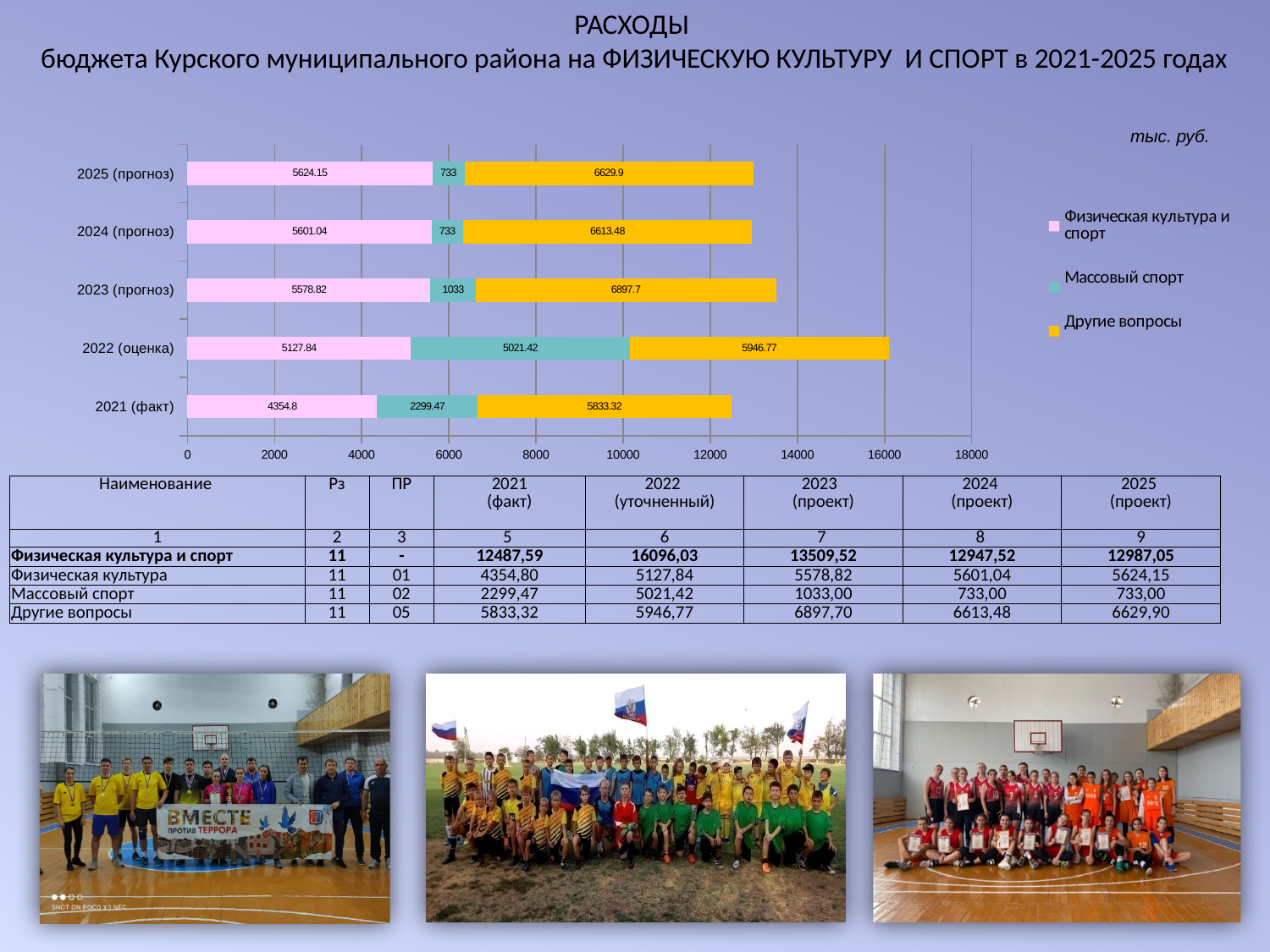
What is the value of Массовый спорт for 2022 (оценка)? 5021.42 What is the difference between the Другие вопросы values for 2025 (прогноз) and 2024 (прогноз)? 16.42 How many year categories are plotted on the chart? 5 What is the total of the stacked bar for 2022 (оценка)? 16096.03 Which year has the lowest value for Физическая культура и спорт? 2021 (факт) Which year has the highest value for Массовый спорт? 2022 (оценка) Which series is shown in yellow in the chart legend? Другие вопросы What is the value of Другие вопросы for 2023 (прогноз)? 6897.7 What is the value of Физическая культура и спорт for 2021 (факт)? 4354.8 Which is larger: Массовый спорт in 2021 (факт) or Массовый спорт in 2023 (прогноз)? 2021 (факт) How many series does the chart legend list? 3 What type of chart is shown on the slide? Stacked bar chart